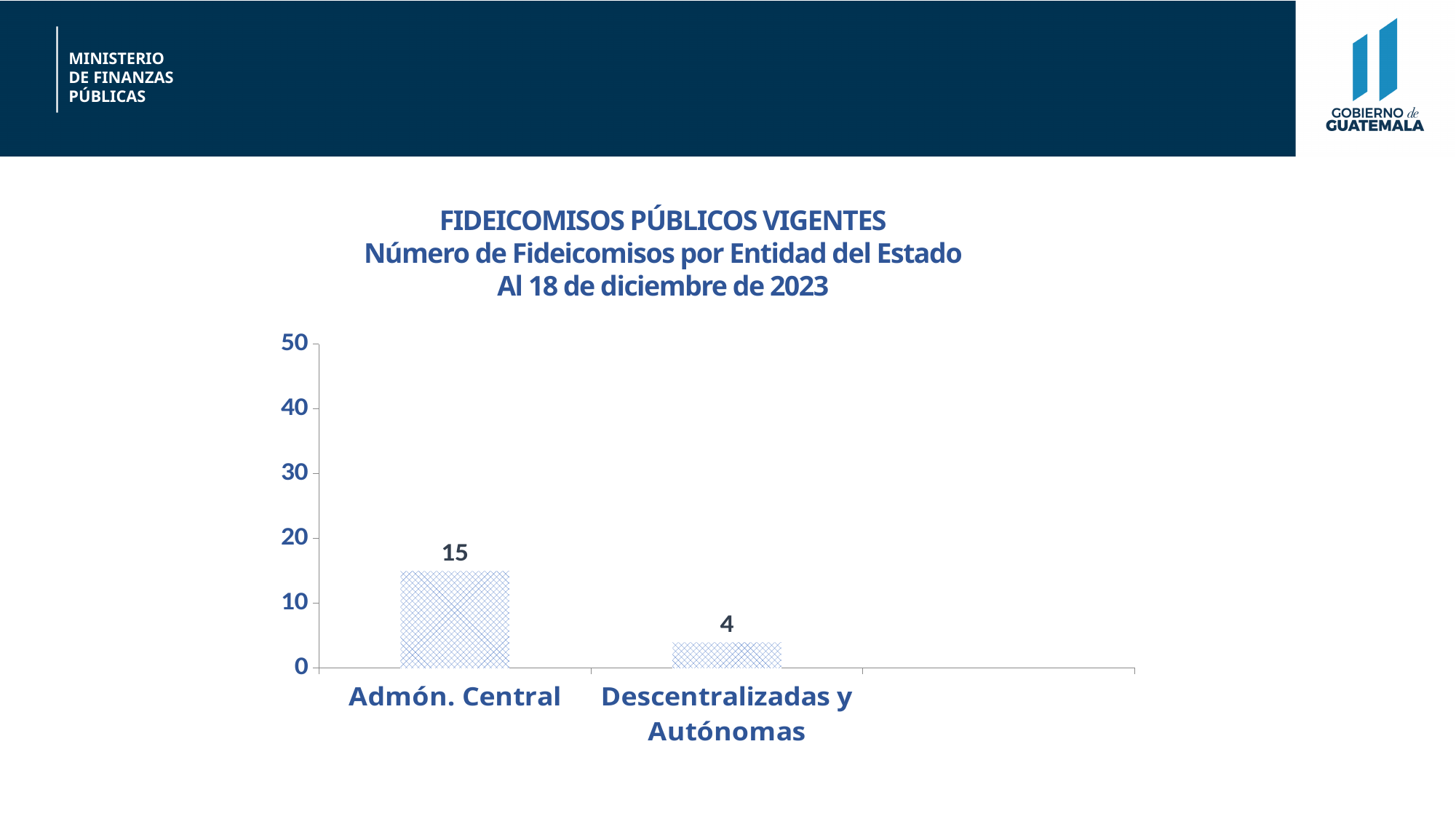
What date does the chart title say the data is as of? 18 de diciembre de 2023 Which category has the highest value? Admón. Central What is the difference between the values for Admón. Central and Descentralizadas y Autónomas? 11 Which is larger, the value for Admón. Central or the value for Descentralizadas y Autónomas? Admón. Central What is the value for Admón. Central? 15 What is the value for Descentralizadas y Autónomas? 4 How many categories are shown on the x axis? 2 Which category has the lowest value? Descentralizadas y Autónomas What is the maximum value shown on the y axis? 50 Is the value for Descentralizadas y Autónomas greater or less than 10? less Is the value for Admón. Central greater or less than 20? less What kind of chart is shown on the slide? bar chart